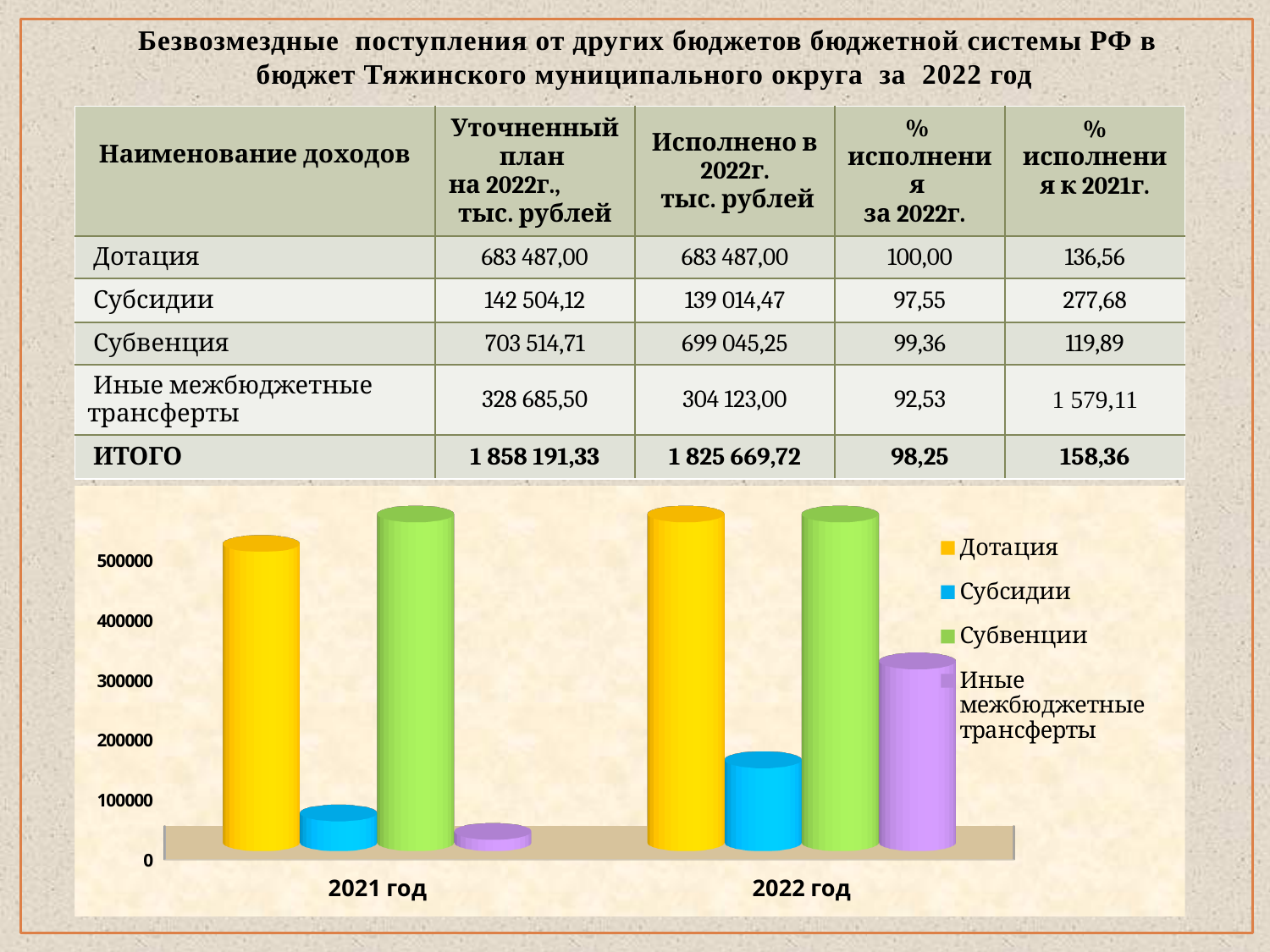
Which series has the lowest bar for 2021 год? Иные межбюджетные трансферты What kind of chart is shown at the bottom of the slide? bar chart How many categories are shown on the x axis of the chart? 2 Is the value for Субсидии in 2022 год greater or less than 200000? less Is the value for Субвенции in 2022 год greater or less than 500000? greater Which series has the highest bar for 2021 год? Субвенции Which is larger: Иные межбюджетные трансферты in 2021 год or in 2022 год? 2022 год How many series does the chart legend list? 4 Is the value for Субсидии in 2021 год greater or less than 100000? less Which series has the lowest bar for 2022 год? Субсидии Does the value for Субсидии rise or fall from 2021 год to 2022 год? rise